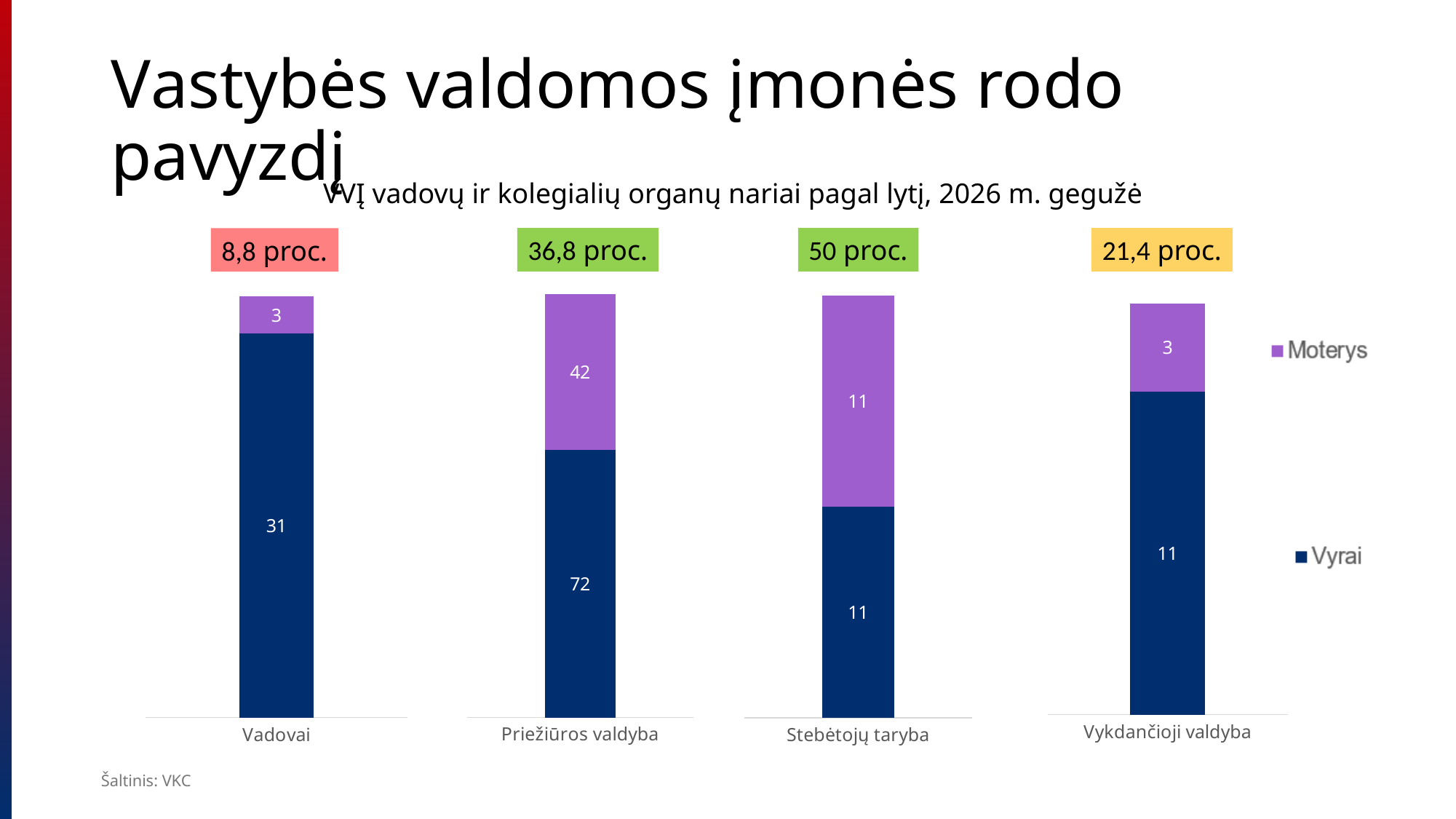
What is the total of the Vadovai stacked bar? 34 What is the value for Moterys in the Stebėtojų taryba bar? 11 What is the difference between Vyrai and Moterys in the Priežiūros valdyba bar? 30 Which category has the highest value for Vyrai? Priežiūros valdyba What is the value for Moterys in the Vadovai bar? 3 Which category has the highest value for Moterys? Priežiūros valdyba How many series does the legend list? 2 What is the value for Vyrai in the Vykdančioji valdyba bar? 11 Which is larger in the Vadovai bar, Vyrai or Moterys? Vyrai What is the value for Vyrai in the Priežiūros valdyba bar? 72 What is the total of the Stebėtojų taryba stacked bar? 22 How many categories are shown on the x axis? 4